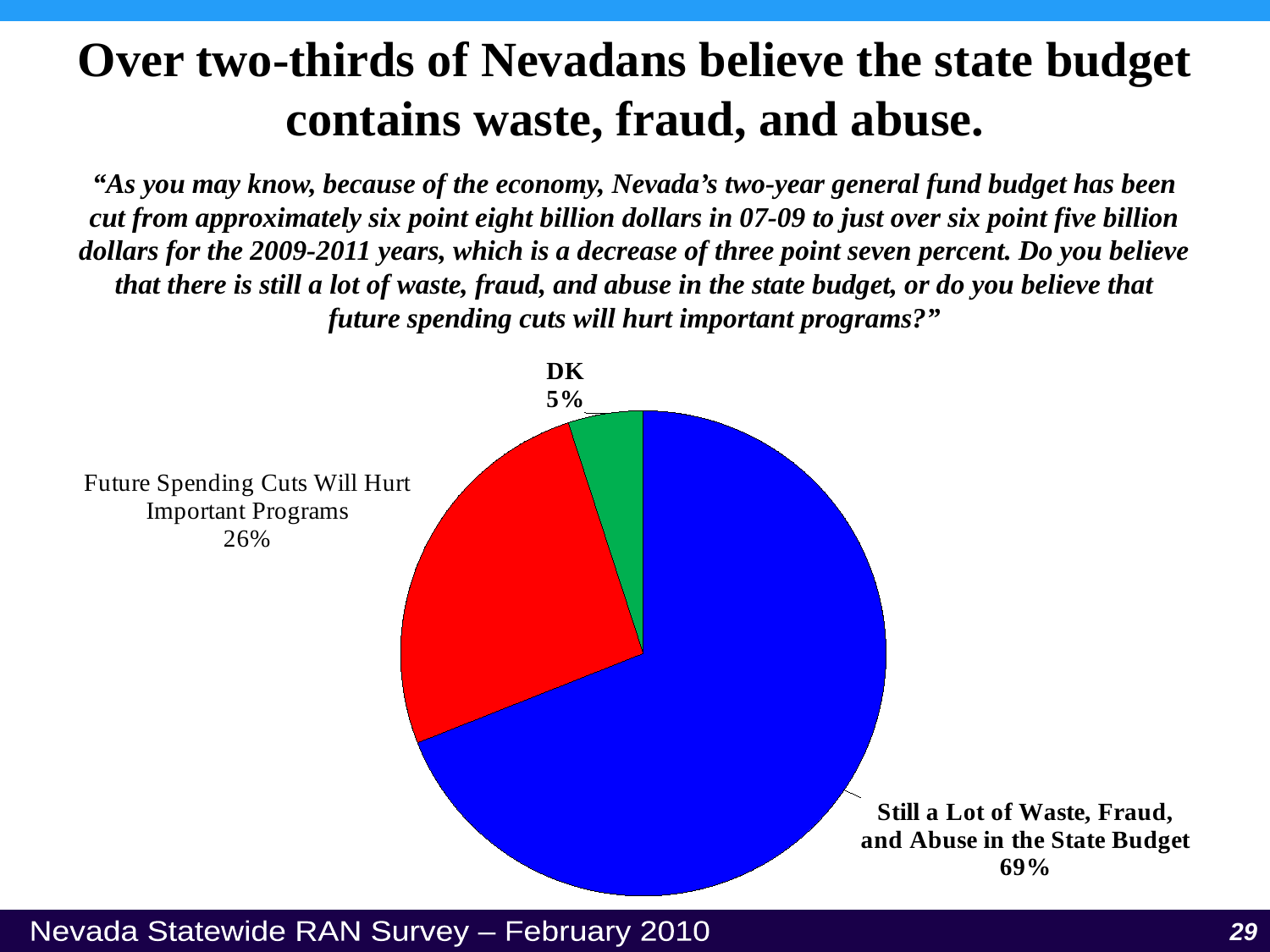
What colour is the DK slice? green How many slices does the pie chart have? 3 What is the combined share of the 'Future Spending Cuts Will Hurt Important Programs' and 'DK' slices? 31% What percentage of respondents said future spending cuts will hurt important programs? 26% What colour is the slice for 'Still a Lot of Waste, Fraud, and Abuse in the State Budget'? blue What percentage of respondents answered DK? 5% Which is larger: the share for 'Future Spending Cuts Will Hurt Important Programs' or the share for 'DK'? Future Spending Cuts Will Hurt Important Programs What kind of chart is shown on the slide? pie chart What percentage of respondents said there is still a lot of waste, fraud, and abuse in the state budget? 69% Which response has the largest share of the pie? Still a Lot of Waste, Fraud, and Abuse in the State Budget What is the difference in percentage points between the 'Still a Lot of Waste, Fraud, and Abuse' slice and the 'Future Spending Cuts Will Hurt Important Programs' slice? 43 percentage points Which response has the smallest share of the pie? DK